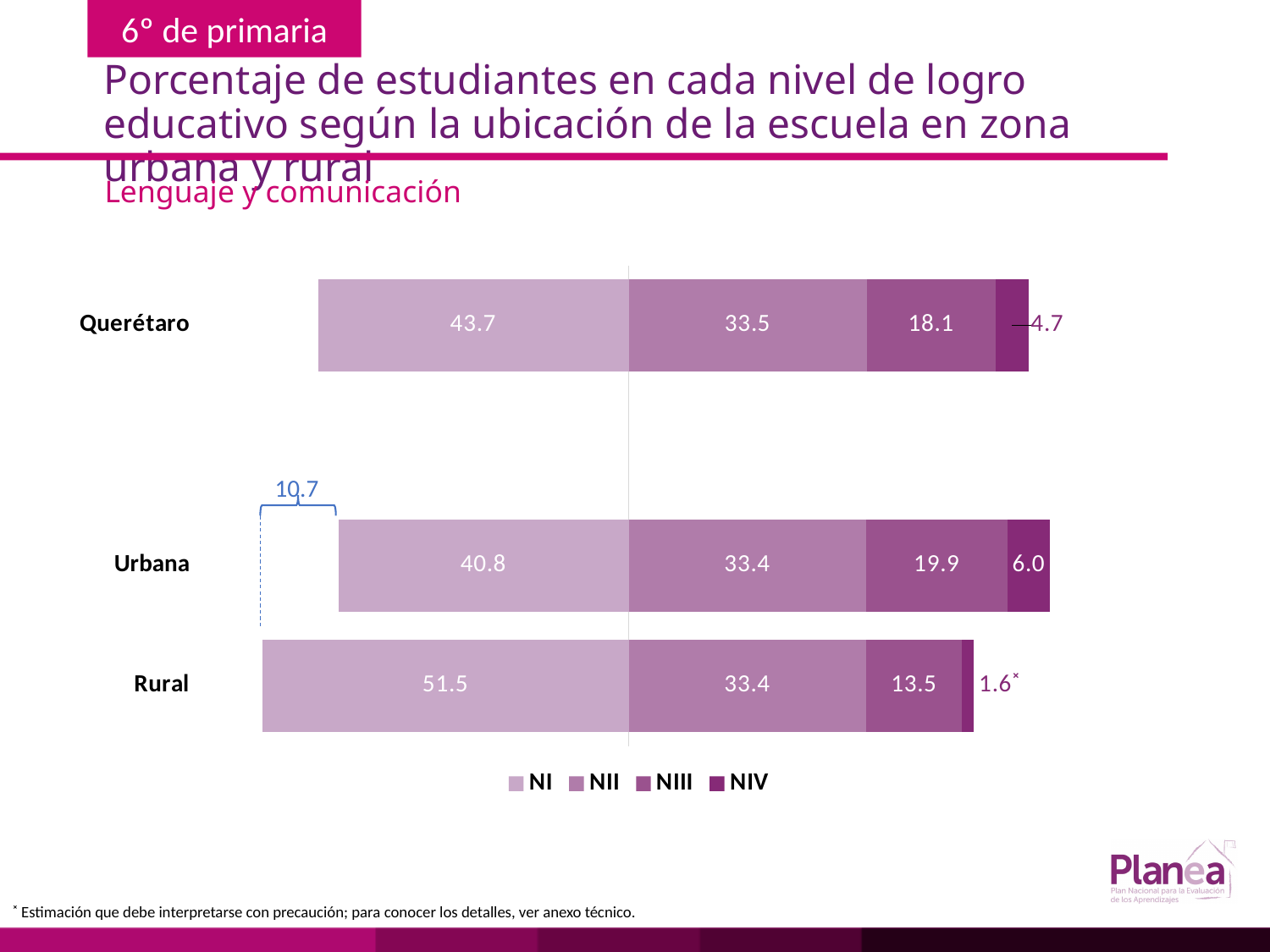
What is the NIV value for Urbana? 6.0 What is the NIII value for Querétaro? 18.1 Which category has the highest NI value? Rural Which category has the lowest NIV value? Rural How many categories are shown on the chart? 3 Which is larger, the NIII value for Urbana or for Rural? Urbana What is the total of the stacked bar for Querétaro? 100.0 How many series does the legend list? 4 What kind of chart is shown on the slide? Stacked bar chart What is the NII value for Rural? 33.4 What percentage of Rural students are at level NI? 51.5 What is the difference between the NI values for Rural and Urbana? 10.7